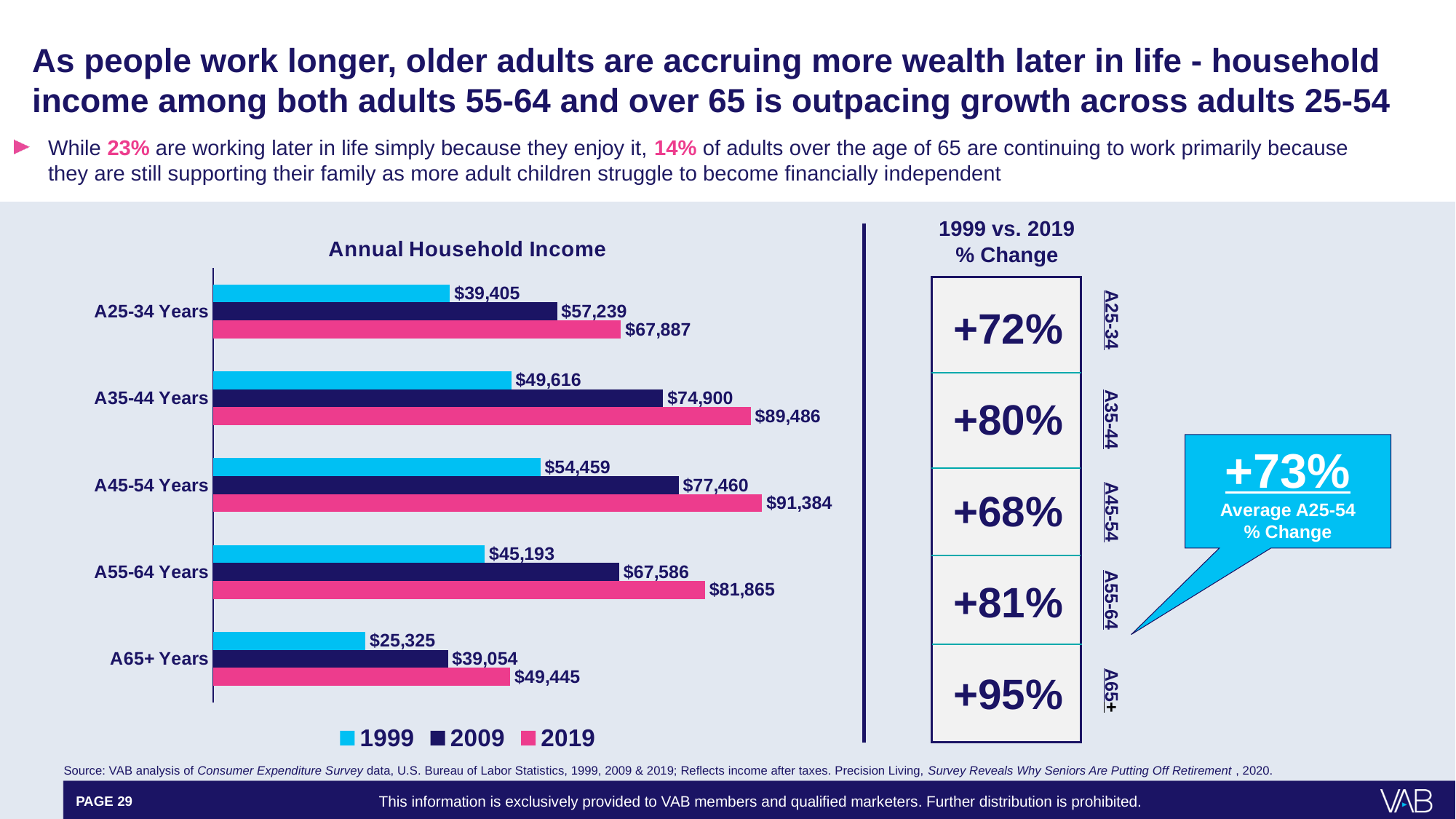
How many series does the legend of the Annual Household Income chart list? 3 How many age categories are shown in the Annual Household Income chart? 5 Which series in the Annual Household Income chart is shown in pink? 2019 Which is larger: the 2009 income for A35-44 Years or the 2009 income for A55-64 Years? A35-44 Years Which age group has the lowest 1999 annual household income? A65+ Years What is the 1999 annual household income for A55-64 Years? $45,193 What type of chart is the Annual Household Income chart? Bar chart Which age group has the highest 2019 annual household income? A45-54 Years What is the difference between the 2019 and 1999 annual household income for A25-34 Years? $28,482 What is the 2009 annual household income for A65+ Years? $39,054 What is the difference between the 2019 and 2009 annual household income for A65+ Years? $10,391 What is the 2019 annual household income for A35-44 Years? $89,486